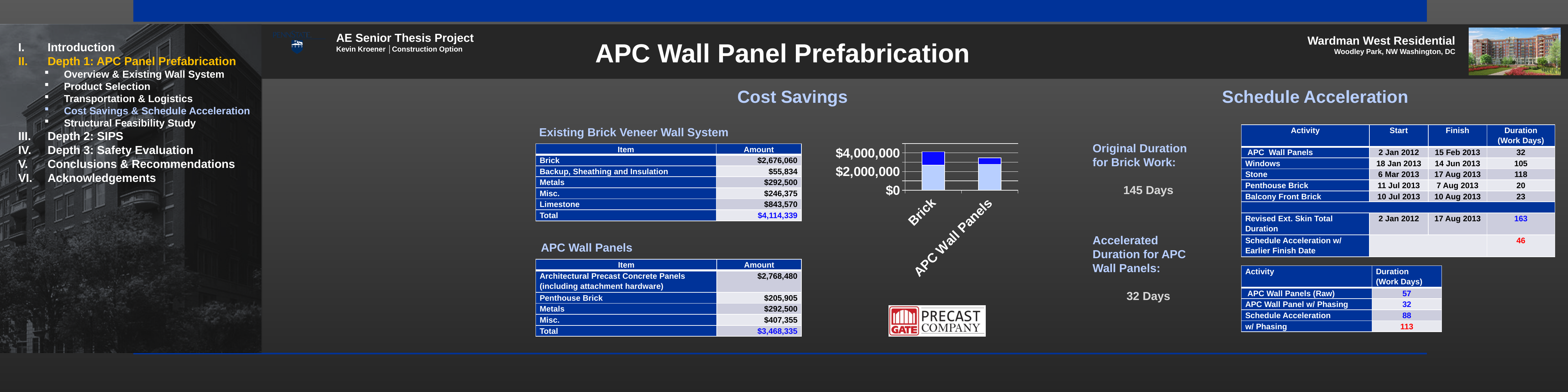
What kind of chart is shown under the Cost Savings heading? bar chart Which category has the tallest bar in the chart? Brick What are the two category labels on the chart's x axis? Brick and APC Wall Panels Do the bar heights rise or fall moving from Brick to APC Wall Panels along the x axis? fall What is the highest value labelled on the chart's y axis? $4,000,000 Is the total bar height for APC Wall Panels greater or less than $2,000,000? greater Which bar is taller, Brick or APC Wall Panels? Brick Is the total bar height for Brick greater or less than $2,000,000? greater How many categories are plotted on the x axis of the bar chart? 2 Which category has the shortest bar in the chart? APC Wall Panels Is the total bar height for APC Wall Panels greater or less than $4,000,000? less